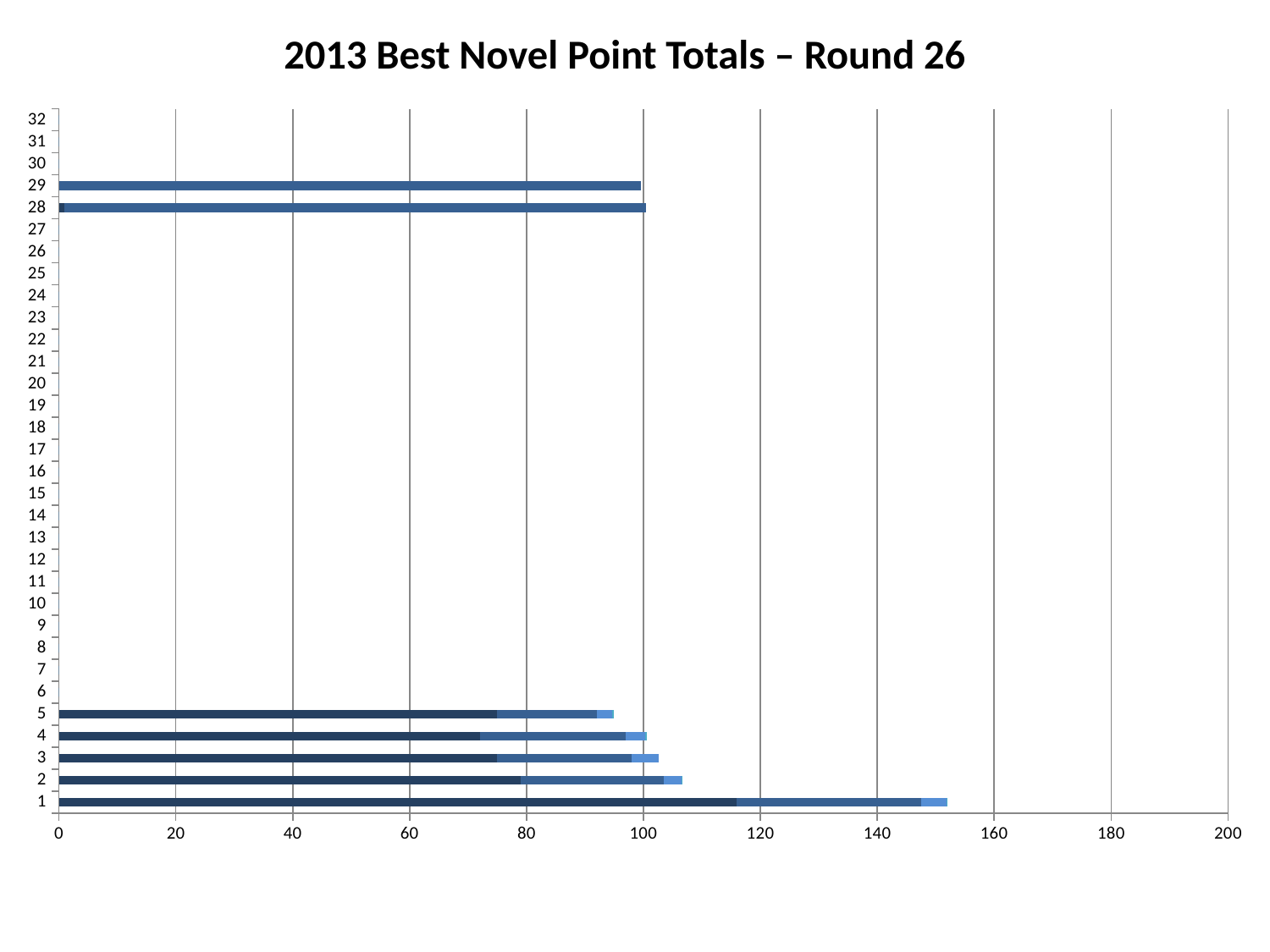
Which has the larger total, category 1 or category 28? 1 What is the highest value shown on the horizontal axis? 200 Is the total for category 1 greater or less than 140? greater Which has the larger total, category 1 or category 2? 1 Which category has the highest total on the chart? 1 What kind of chart is shown on the slide? bar chart Which has the larger total, category 2 or category 5? 2 What is the title of the chart? 2013 Best Novel Point Totals – Round 26 Is the total for category 2 greater or less than 100? greater Is the total for category 5 greater or less than 100? less How many categories are listed on the vertical axis? 32